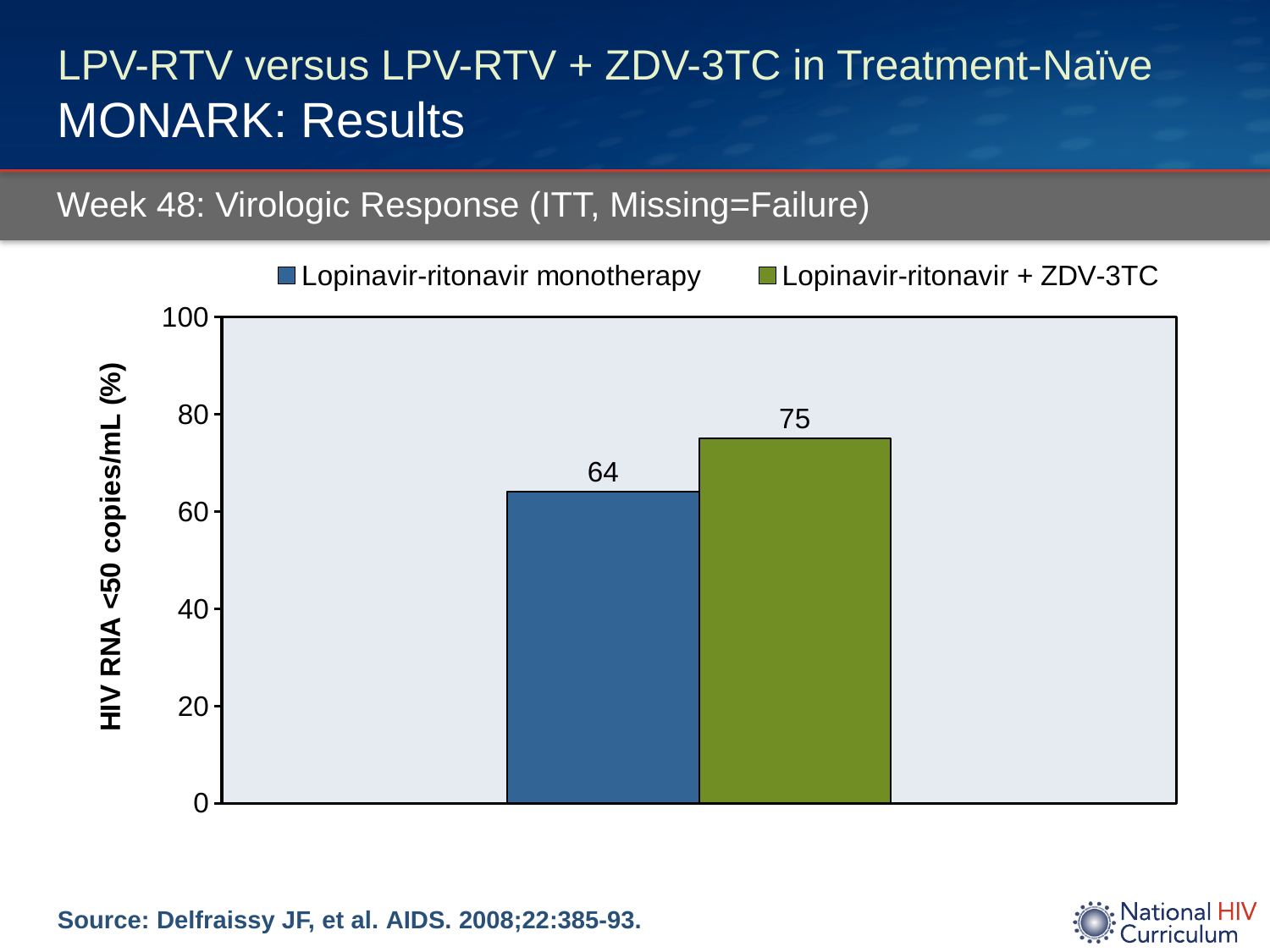
What is the label of the y axis? HIV RNA <50 copies/mL (%) How many bars are plotted on the chart? 2 What is the value for Lopinavir-ritonavir monotherapy? 64 Which series has the lower value? Lopinavir-ritonavir monotherapy What kind of chart is shown? bar chart What is the value for Lopinavir-ritonavir + ZDV-3TC? 75 What is the difference between the Lopinavir-ritonavir + ZDV-3TC value and the Lopinavir-ritonavir monotherapy value? 11 Which series has the higher value? Lopinavir-ritonavir + ZDV-3TC Is the value for Lopinavir-ritonavir monotherapy larger or smaller than the value for Lopinavir-ritonavir + ZDV-3TC? smaller Is the value for Lopinavir-ritonavir + ZDV-3TC greater or less than 80? less How many series does the legend list? 2 Is the value for Lopinavir-ritonavir monotherapy greater or less than 60? greater